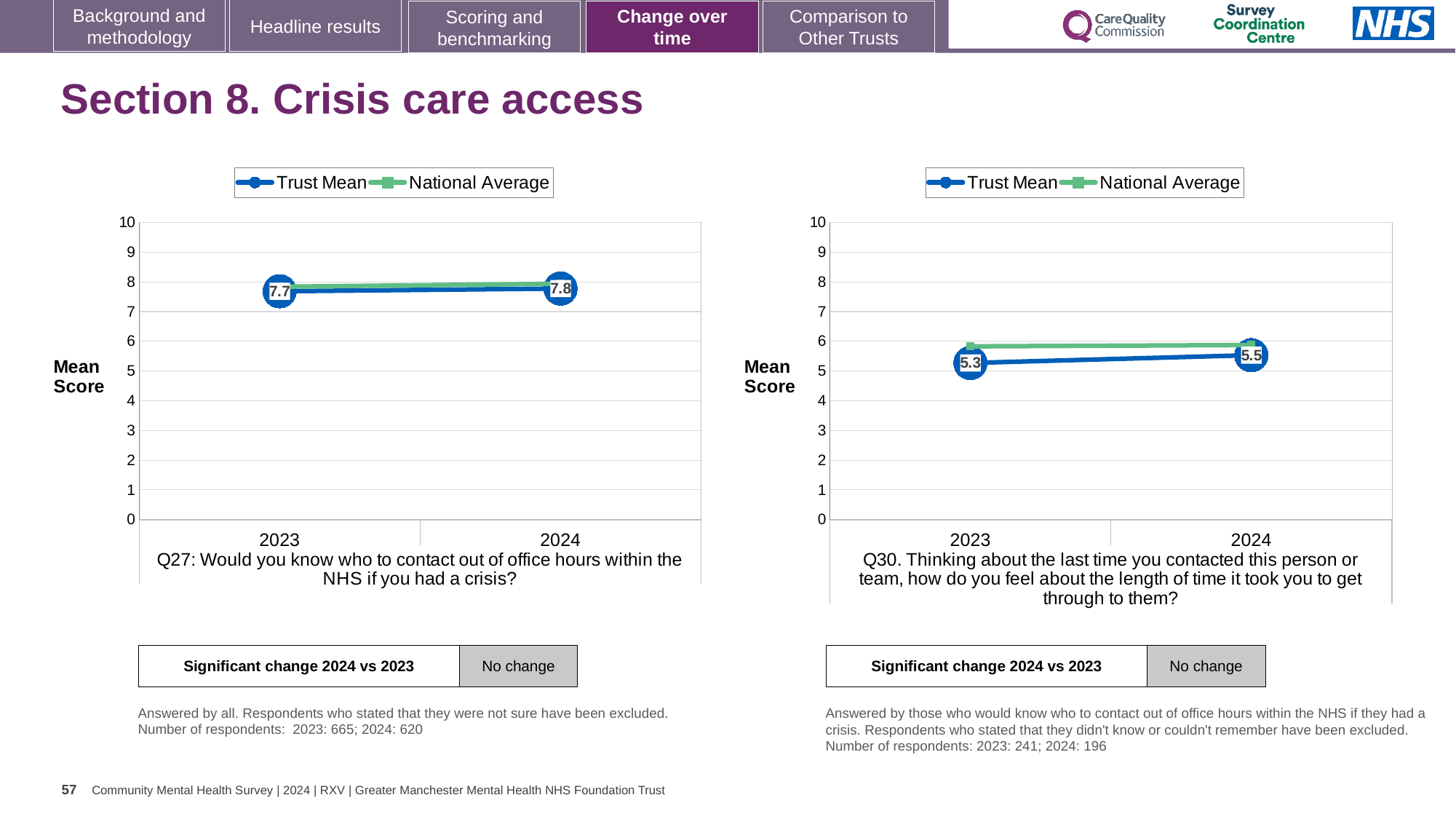
In the right chart (Q30), does the Trust Mean rise or fall from 2023 to 2024? rise How many series does the legend of the right chart (Q30) list? 2 In the left chart (Q27), what is the Trust Mean score for 2024? 7.8 In the right chart (Q30), what is the Trust Mean score for 2023? 5.3 In the right chart (Q30), which is higher in 2023, the Trust Mean or the National Average? National Average In the right chart (Q30), what is the Trust Mean score for 2024? 5.5 In the right chart (Q30), is the National Average for 2023 greater or less than 5? greater In the left chart (Q27), what is the Trust Mean score for 2023? 7.7 In the right chart (Q30), by how much did the Trust Mean change from 2023 to 2024? 0.2 What type of chart is the left chart (Q27)? line chart In the left chart (Q27), by how much did the Trust Mean change from 2023 to 2024? 0.1 How many years are plotted on the x axis of the left chart (Q27)? 2